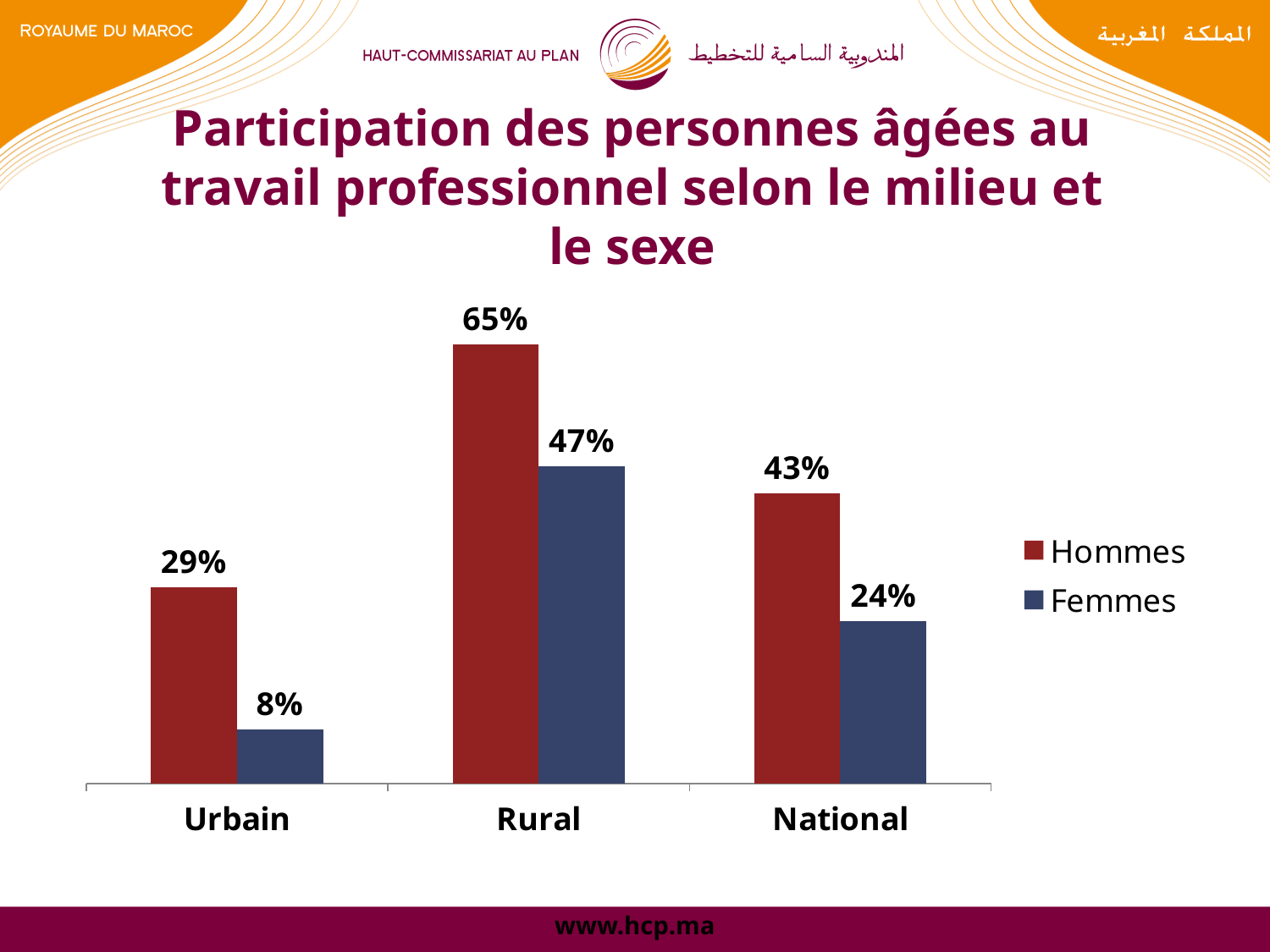
What is the difference between the Hommes and Femmes values in the Urbain category? 21% What is the value for Femmes in the Urbain category? 8% How many series does the legend list? 2 What is the value for Hommes in the Rural category? 65% Which category has the highest value for Hommes? Rural What is the value for Femmes in the National category? 24% Which is larger: the Hommes value for National or the Femmes value for Rural? Femmes value for Rural What is the difference between the Rural and National values for Femmes? 23% What kind of chart is shown on the slide? Bar chart How many categories are shown on the x axis? 3 Which category has the lowest value for Femmes? Urbain Which series is shown in dark red? Hommes